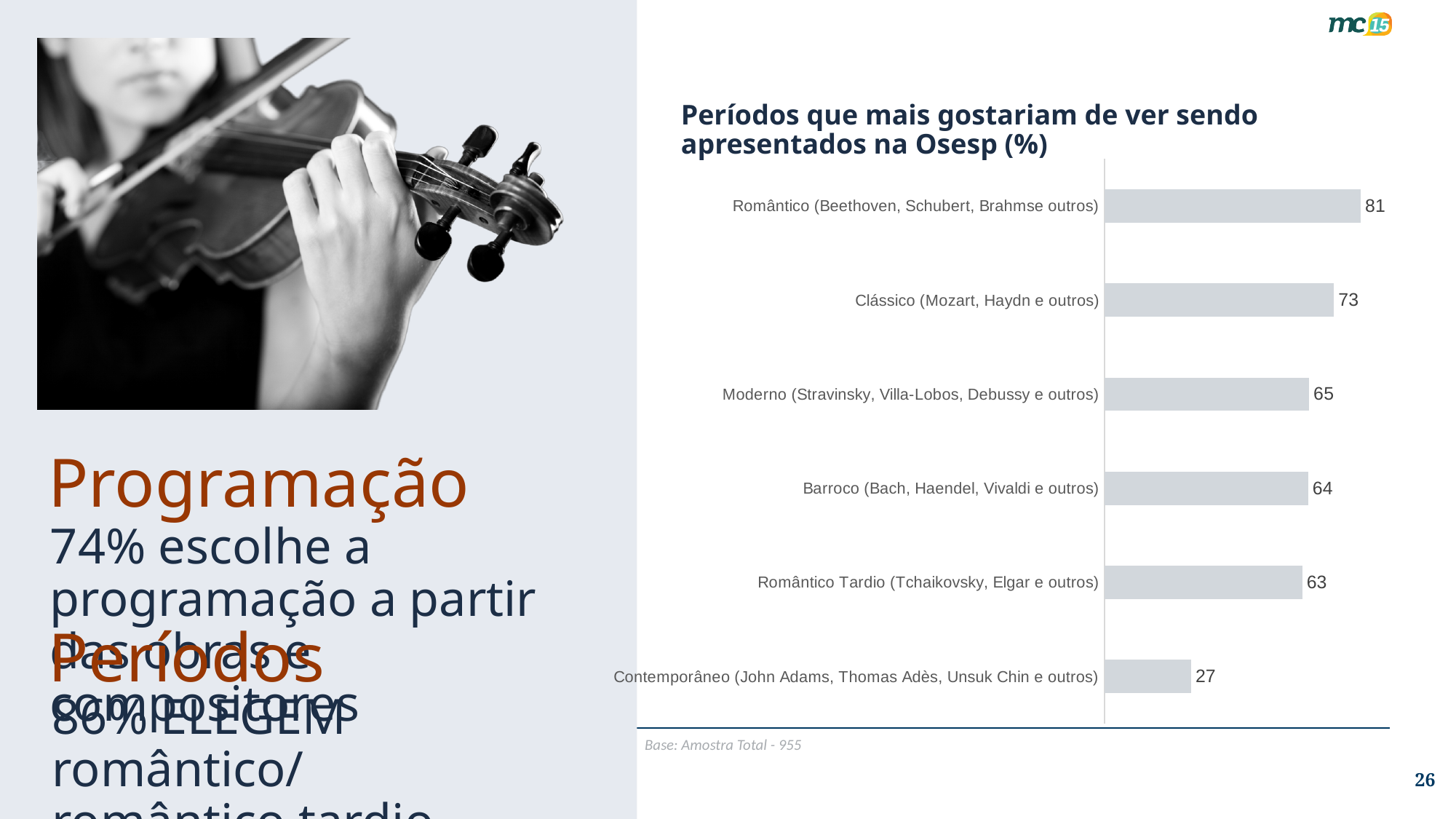
What is the value for Contemporâneo (John Adams, Thomas Adès, Unsuk Chin e outros)? 27 What kind of chart is shown on the slide? Bar chart What is the value for Clássico (Mozart, Haydn e outros)? 73 What is the difference between the values for Moderno and Contemporâneo? 38 What is the difference between the values for Romântico and Clássico? 8 Which period has the lowest value? Contemporâneo (John Adams, Thomas Adès, Unsuk Chin e outros) What is the value for Romântico (Beethoven, Schubert, Brahms e outros)? 81 Which has a larger value, Clássico or Moderno? Clássico What is the title of the chart? Períodos que mais gostariam de ver sendo apresentados na Osesp (%) Which period has the highest value? Romântico (Beethoven, Schubert, Brahms e outros) How many periods are shown in the chart? 6 What is the value for Barroco (Bach, Haendel, Vivaldi e outros)? 64